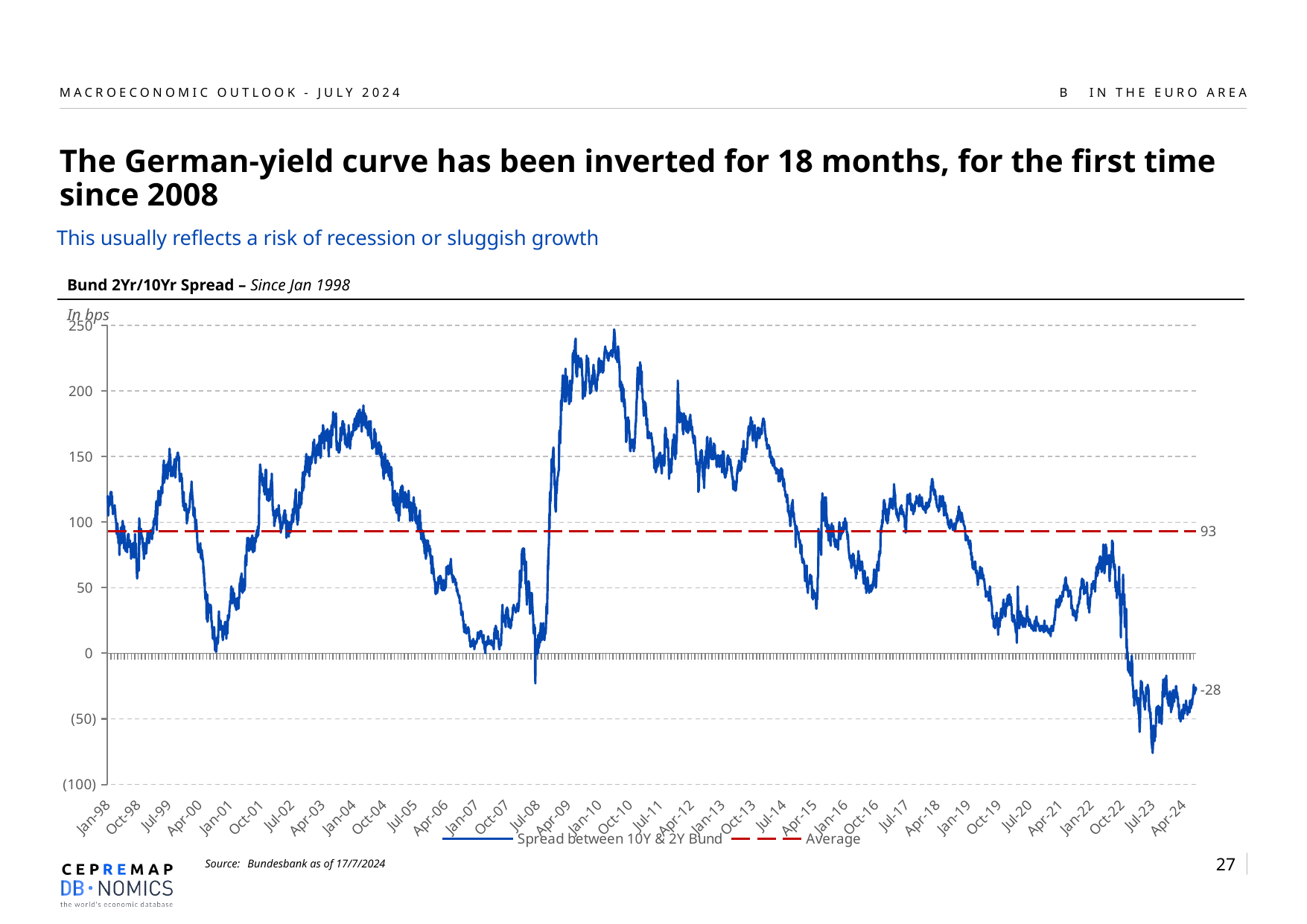
In what unit are the values on the chart expressed? bps What kind of chart is shown on the slide? line chart What is the difference between the Average (93) and the latest spread value (-28)? 121 How many series does the legend list? 2 Between Jan-22 and Jul-23, does the spread rise or fall? fall Is the spread around Jan-07 greater or less than 50? less Is the spread around Jul-23 greater or less than 0? less What is the title of the chart? Bund 2Yr/10Yr Spread – Since Jan 1998 Is the spread around Jan-10 greater or less than 200? greater What is the latest value of the spread between 10Y & 2Y Bund labelled at the end of the line? -28 What is the value of the Average line shown on the chart? 93 Which is larger: the Average value or the latest spread value? Average